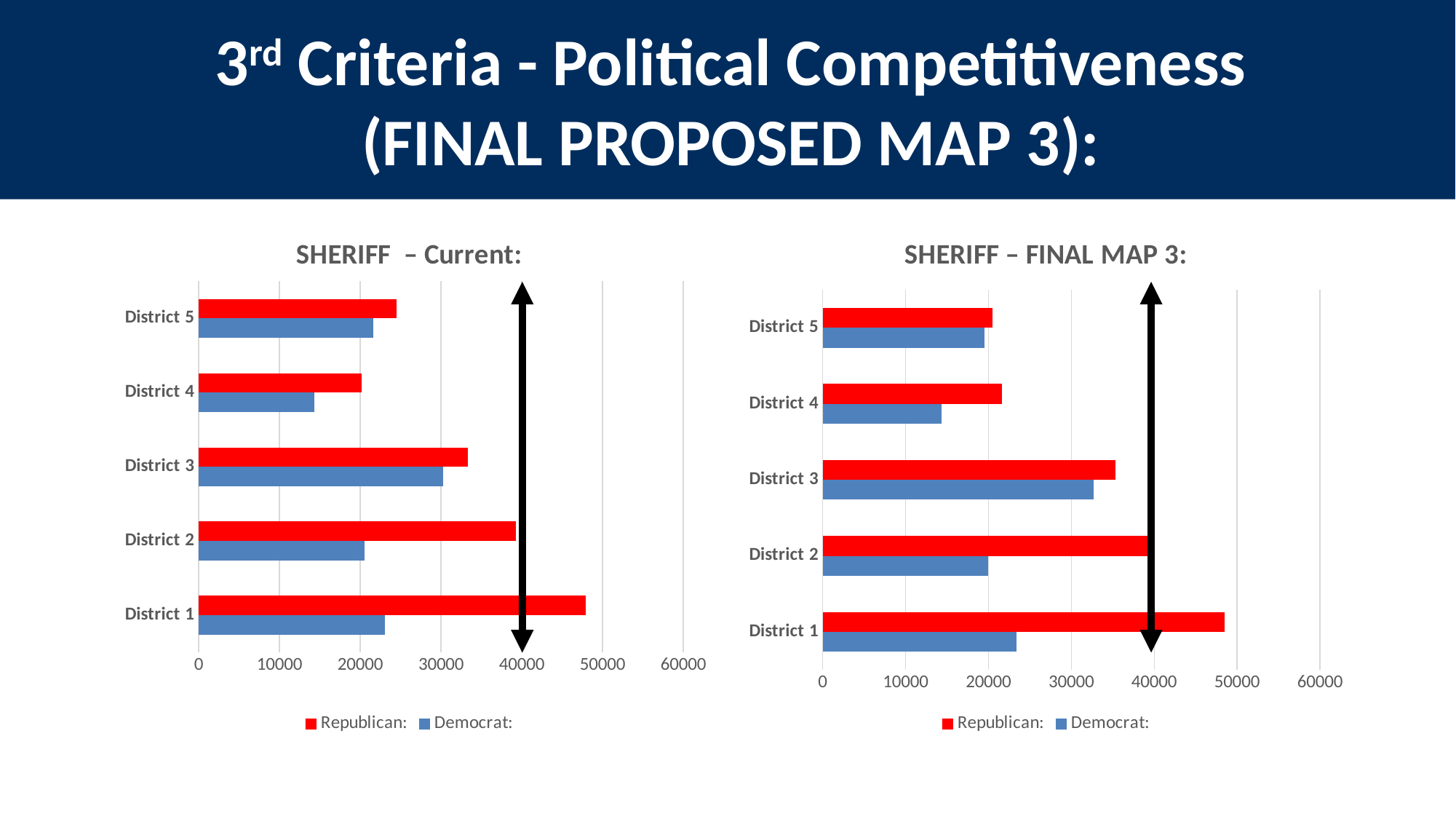
What type of chart is the SHERIFF – Current chart? bar chart On the SHERIFF – FINAL MAP 3 chart, which district has the lowest Democrat value? District 4 On the SHERIFF – Current chart, which district has the highest Republican value? District 1 Which colour represents the Democrat series on the SHERIFF – FINAL MAP 3 chart? blue On the SHERIFF – Current chart, which is larger for District 2, the Republican value or the Democrat value? Republican On the SHERIFF – FINAL MAP 3 chart, which district has the highest Republican value? District 1 How many districts are shown on the SHERIFF – FINAL MAP 3 chart? 5 On the SHERIFF – Current chart, is the Democrat value for District 4 greater or less than 20000? less On the SHERIFF – Current chart, is the Republican value for District 1 greater or less than 40000? greater How many series does the legend of the SHERIFF – Current chart list? 2 On the SHERIFF – FINAL MAP 3 chart, is the Republican value for District 3 greater or less than 30000? greater